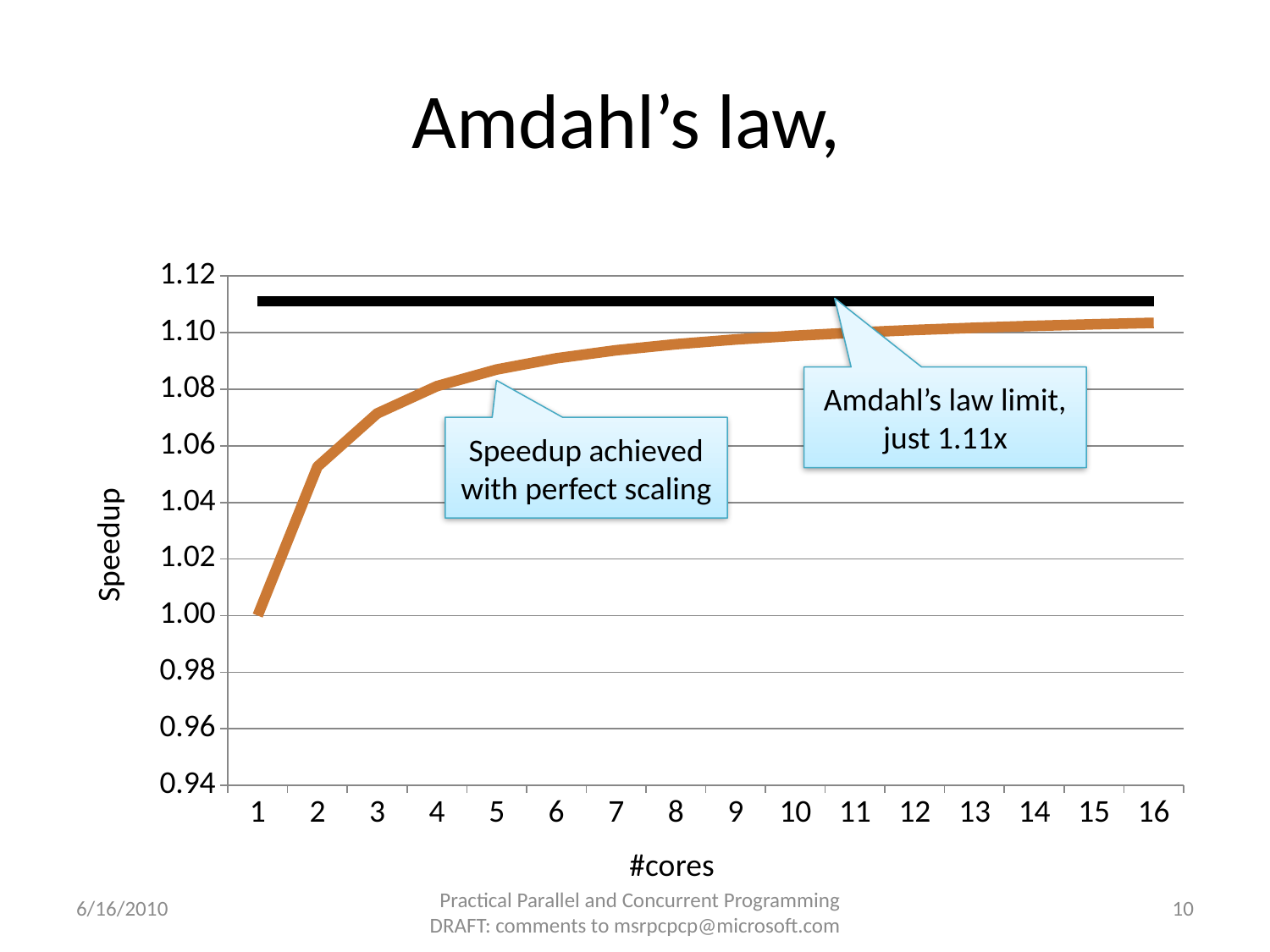
Is the speedup at 2 cores greater or less than 1.04? greater Which has the larger speedup, 2 cores or 16 cores? 16 cores Does the speedup rise or fall as the number of cores increases? rises What is the label on the x axis of the chart? #cores Which number of cores gives the highest speedup? 16 Is the speedup at 4 cores greater or less than 1.06? greater What is the speedup at 1 core? 1.00 What kind of chart is shown on the slide? line chart Is the speedup at 8 cores greater or less than 1.08? greater Which number of cores gives the lowest speedup? 1 How many core counts are plotted along the x axis? 16